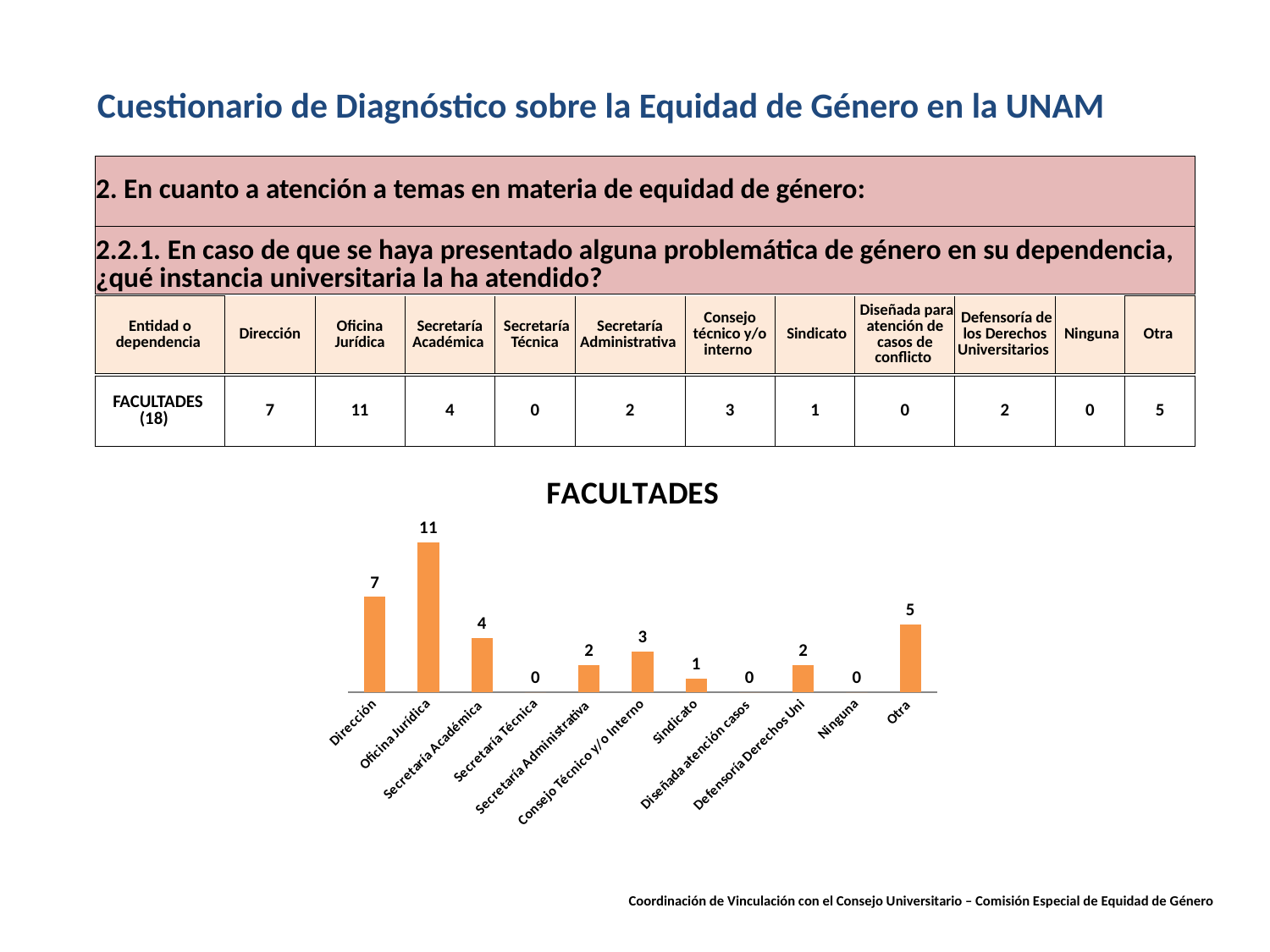
What kind of chart is the FACULTADES chart? Bar chart Which is larger in the FACULTADES chart, Secretaría Académica or Otra? Otra What is the value for Sindicato in the FACULTADES chart? 1 What is the title of the chart on the slide? FACULTADES What is the value for Consejo Técnico y/o Interno in the FACULTADES chart? 3 What is the difference between the values for Oficina Jurídica and Dirección in the FACULTADES chart? 4 What is the value for Oficina Jurídica in the FACULTADES chart? 11 What is the value for Dirección in the FACULTADES chart? 7 What is the value for Otra in the FACULTADES chart? 5 How many categories in the FACULTADES chart have a value of 0? 3 How many categories are shown on the x axis of the FACULTADES chart? 11 Which category has the highest value in the FACULTADES chart? Oficina Jurídica